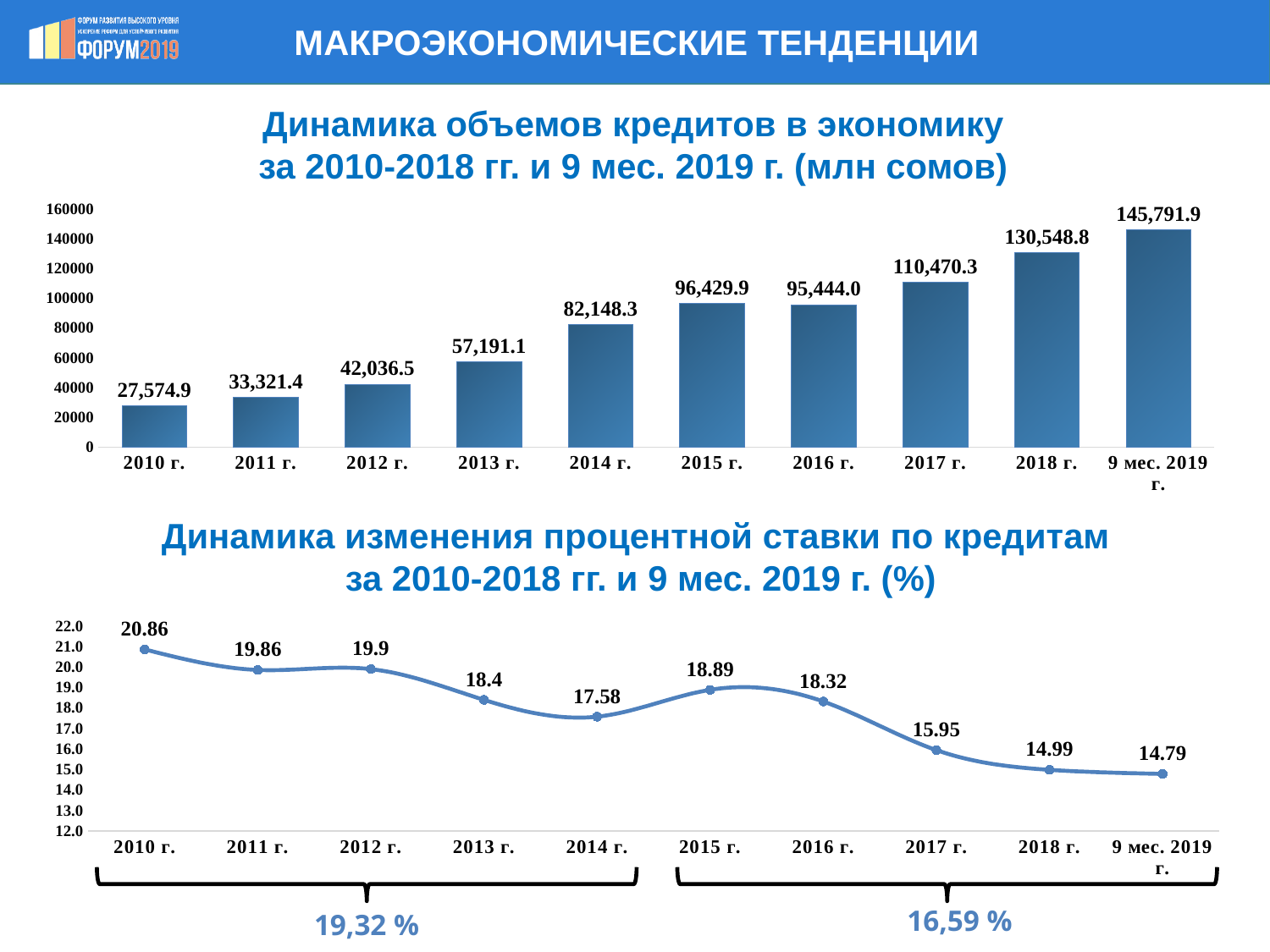
In the top bar chart (Динамика объемов кредитов в экономику), what is the value for 2014 г.? 82,148.3 In the bottom line chart (Динамика изменения процентной ставки по кредитам), which category has the highest value? 2010 г. In the top bar chart (Динамика объемов кредитов в экономику), how many categories are shown on the x axis? 10 In the top bar chart (Динамика объемов кредитов в экономику), which category has the lowest value? 2010 г. In the top bar chart (Динамика объемов кредитов в экономику), which is larger, the value for 2015 г. or 2016 г.? 2015 г. In the top bar chart (Динамика объемов кредитов в экономику), what is the difference between the values for 2018 г. and 2017 г.? 20,078.5 What kind of chart is the top chart (Динамика объемов кредитов в экономику)? bar chart In the bottom line chart (Динамика изменения процентной ставки по кредитам), what is the difference between the values for 2017 г. and 2018 г.? 0.96 In the bottom line chart (Динамика изменения процентной ставки по кредитам), do the values generally rise or fall from 2010 г. to 9 мес. 2019 г.? fall In the top bar chart (Динамика объемов кредитов в экономику), which category has the highest value? 9 мес. 2019 г. In the bottom line chart (Динамика изменения процентной ставки по кредитам), which category has the lowest value? 9 мес. 2019 г. In the bottom line chart (Динамика изменения процентной ставки по кредитам), what is the value for 2017 г.? 15.95